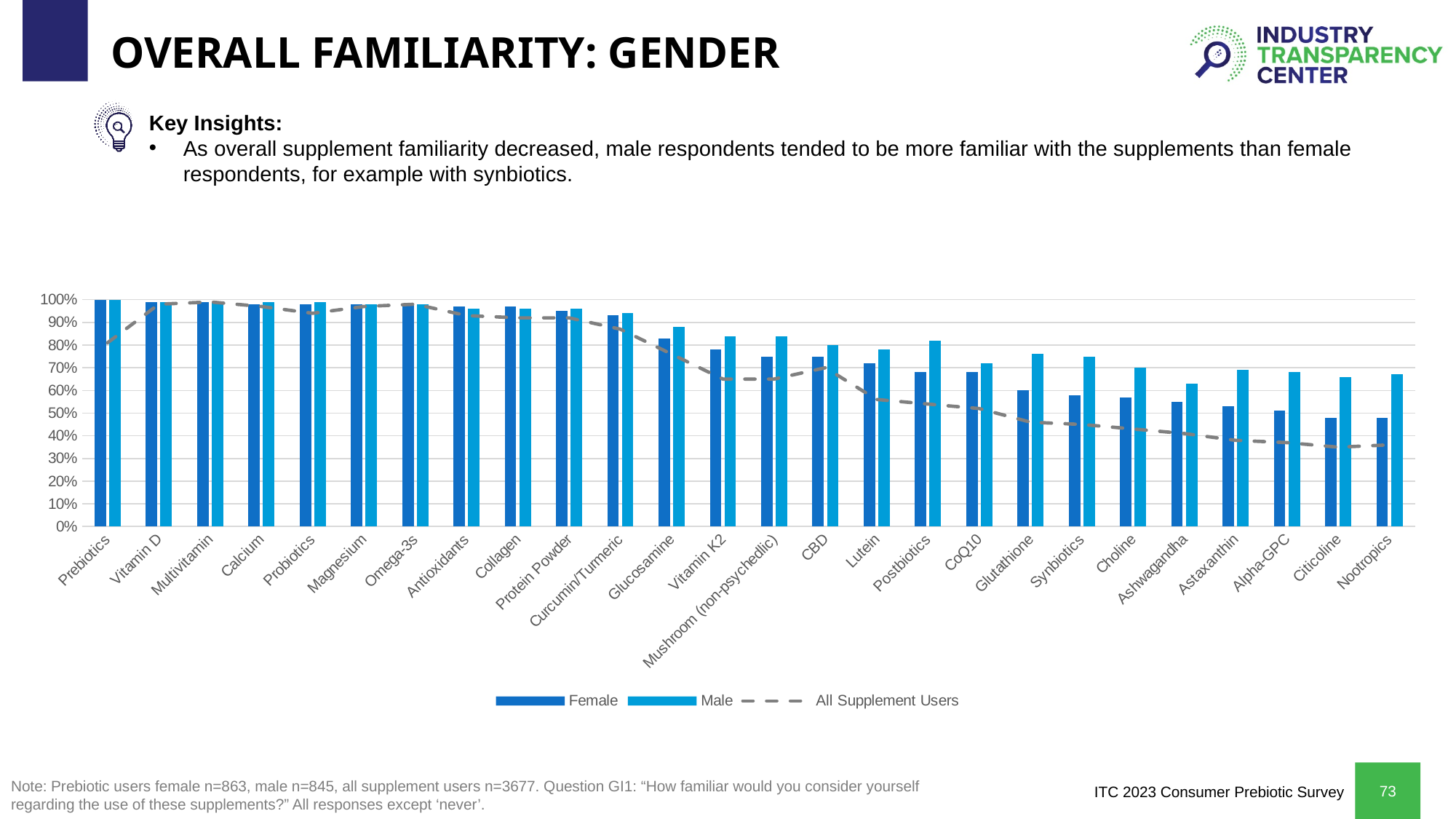
What kind of chart is shown on the slide? combination bar and line chart How many series does the legend list? 3 Which series is drawn as a dashed line? All Supplement Users Is the Male value for Citicoline greater or less than 60%? greater Is the Female value for Nootropics greater or less than 50%? less For Synbiotics, which is larger, the Female value or the Male value? Male Do the familiarity values generally rise or fall moving from left to right along the x axis? fall How many supplement categories are shown on the x axis? 26 For Vitamin K2, which is larger, the Female value or the Male value? Male Which supplement has the highest familiarity for both Female and Male respondents? Prebiotics Is the Female value for Synbiotics greater or less than 50%? greater What is the Female value for Prebiotics? 100%